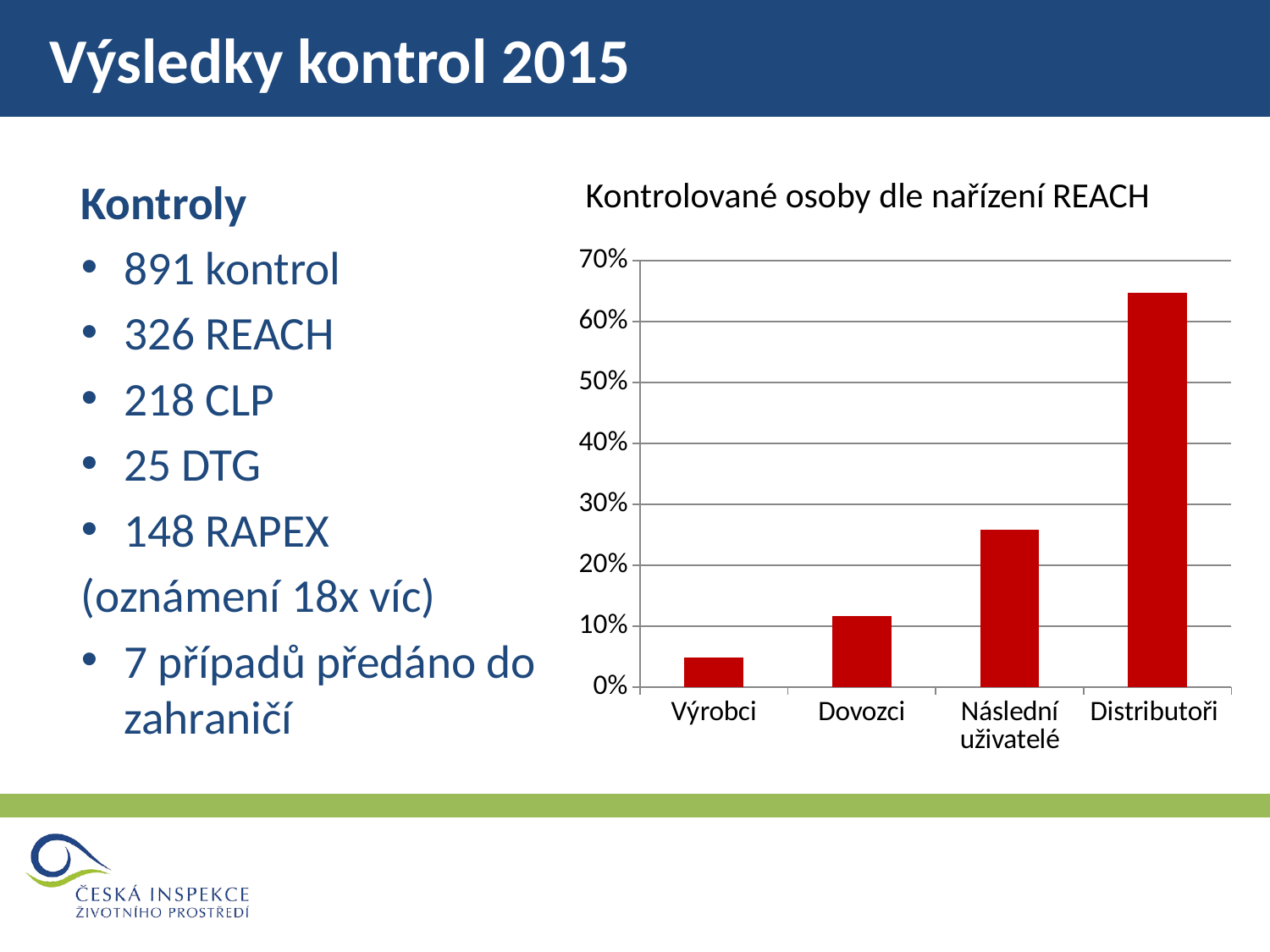
Is the value for Distributoři greater or less than 60%? greater Which category has the lowest value in the chart? Výrobci What is the title of the chart? Kontrolované osoby dle nařízení REACH Which is larger, the value for Dovozci or the value for Následní uživatelé? Následní uživatelé Is the value for Výrobci greater or less than 10%? less Is the value for Dovozci greater or less than 10%? greater What type of chart is shown on the slide? bar chart How many categories are shown on the x axis of the chart? 4 Do the values rise or fall from left to right along the x axis? rise What colour are the bars in the chart? red Which category has the highest value in the chart? Distributoři